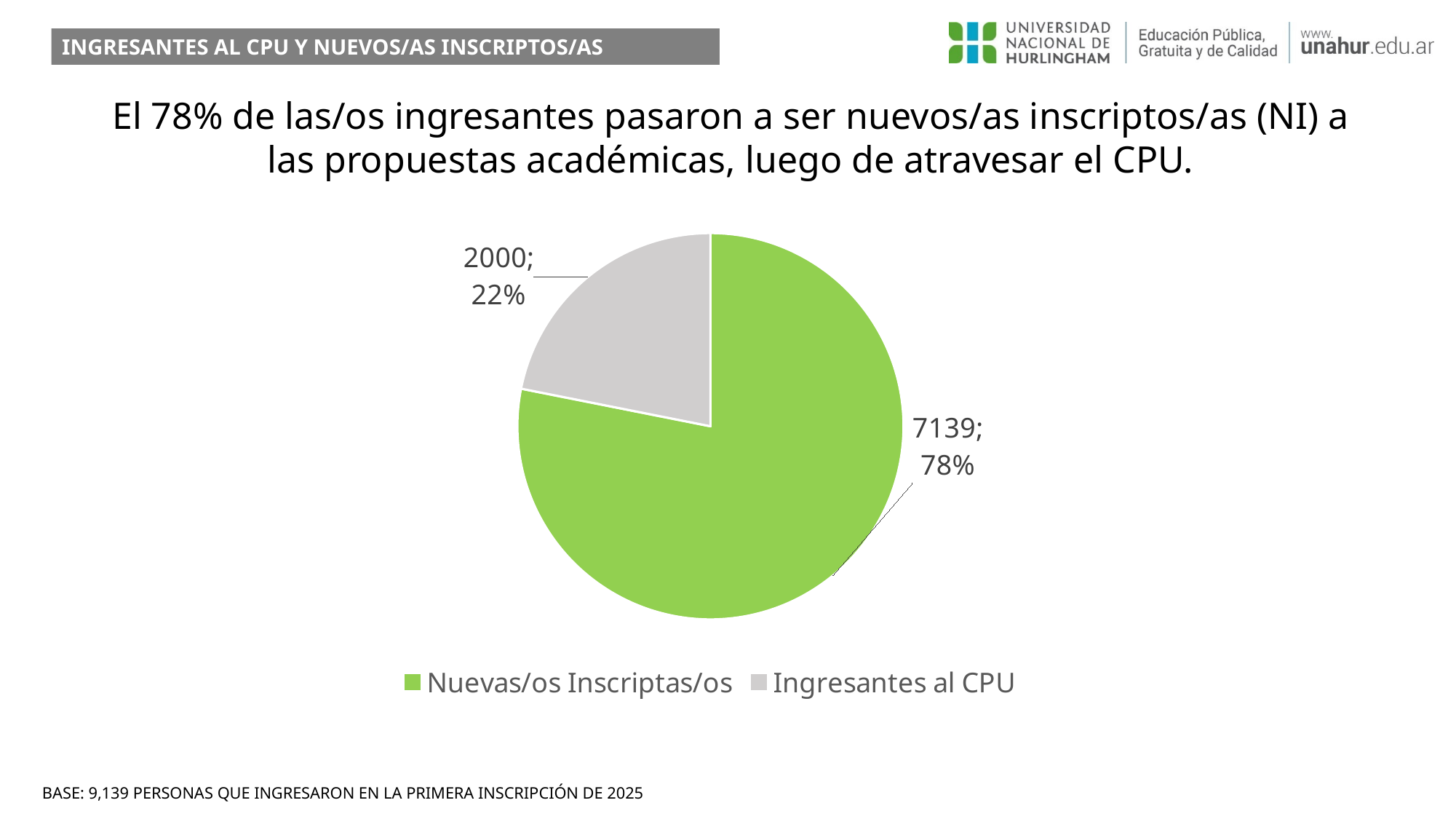
What is the difference between the values for Nuevas/os Inscriptas/os and Ingresantes al CPU? 5139 Which is larger, Nuevas/os Inscriptas/os or Ingresantes al CPU? Nuevas/os Inscriptas/os What share of the pie does Nuevas/os Inscriptas/os represent? 78% What is the value for Ingresantes al CPU? 2000 How many slices does the pie chart have? 2 What colour is the Ingresantes al CPU slice? grey Which slice is the smallest? Ingresantes al CPU How many entries does the legend list? 2 Which slice is the largest? Nuevas/os Inscriptas/os What is the value for Nuevas/os Inscriptas/os? 7139 What kind of chart is shown on the slide? pie chart What share of the pie does Ingresantes al CPU represent? 22%